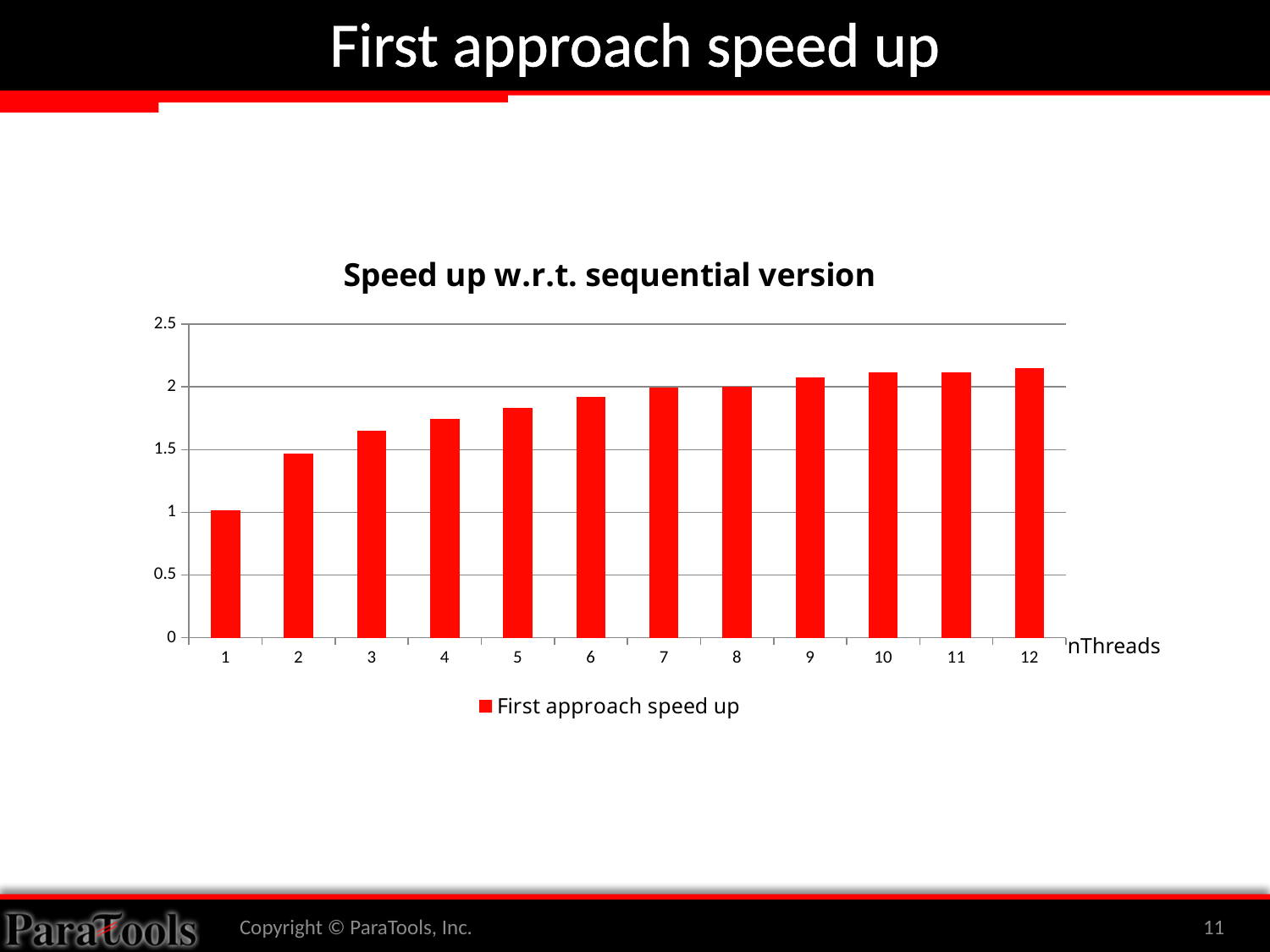
What is the title of the chart? Speed up w.r.t. sequential version How many thread counts (categories) are plotted on the x axis? 12 Is the speed up for 1 thread greater or less than 1.5? less How many series does the legend list? 1 What kind of chart is shown on the slide? bar chart Which thread count has the lowest speed up? 1 Is the speed up for 6 threads greater or less than 2? less Do the speed up values generally rise or fall as the number of threads increases? rise Is the speed up for 10 threads greater or less than 2? greater What label is shown on the x axis of the chart? nThreads Which has the larger speed up, 5 threads or 9 threads? 9 threads